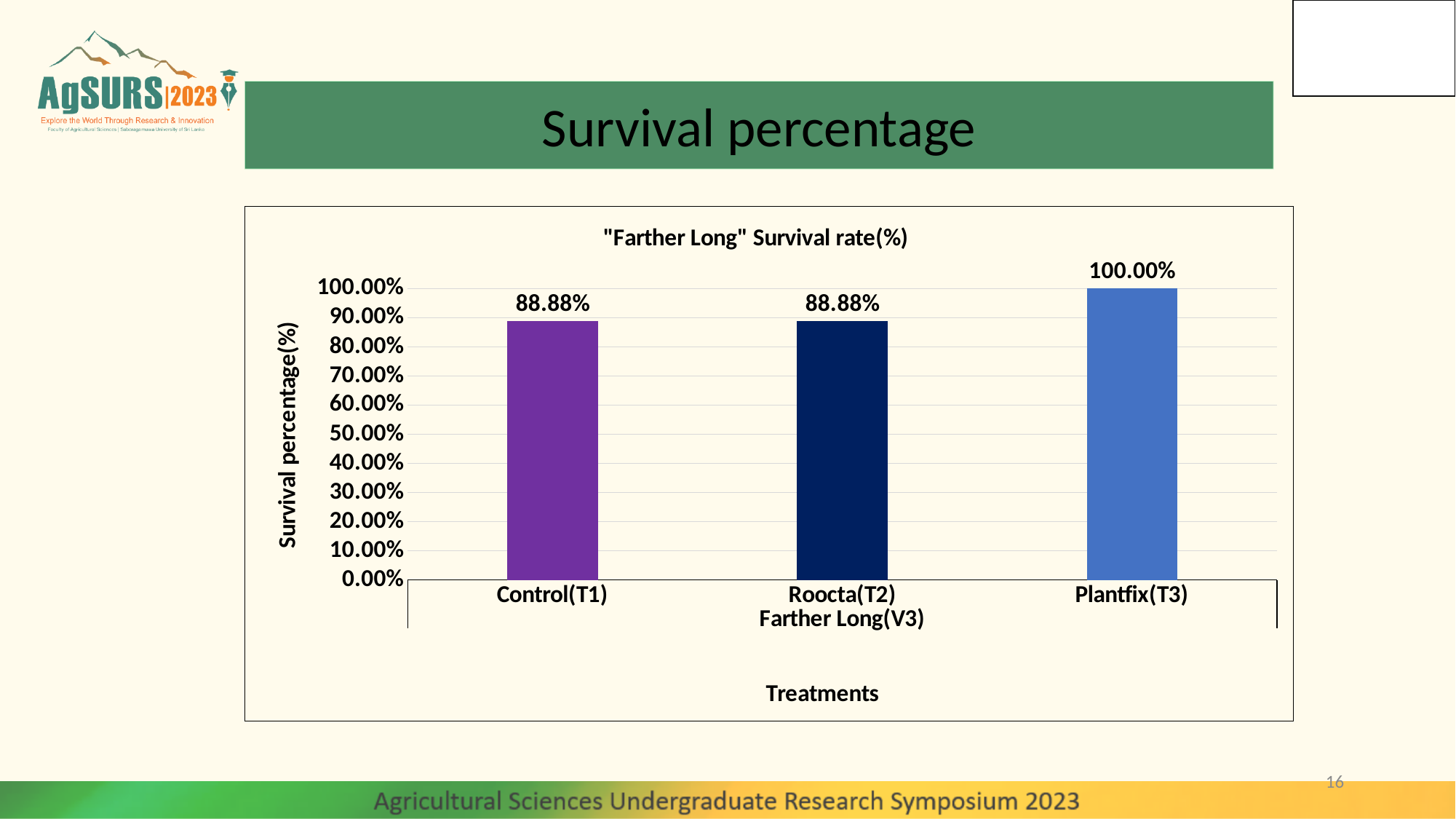
What is the label of the x axis? Treatments Do the survival rates for Control(T1) and Roocta(T2) differ? No, both are 88.88% Which treatment has the highest survival rate? Plantfix(T3) What type of chart is shown on the slide? bar chart What is the survival rate for Control(T1)? 88.88% Which has a higher survival rate, Plantfix(T3) or Roocta(T2)? Plantfix(T3) What is the survival rate for Roocta(T2)? 88.88% What is the difference in survival rate between Plantfix(T3) and Control(T1)? 11.12% Is the survival rate for Control(T1) greater or less than 80.00%? greater How many treatments are shown in the chart? 3 What is the survival rate for Plantfix(T3)? 100.00% What is the title of the chart? "Farther Long" Survival rate(%)